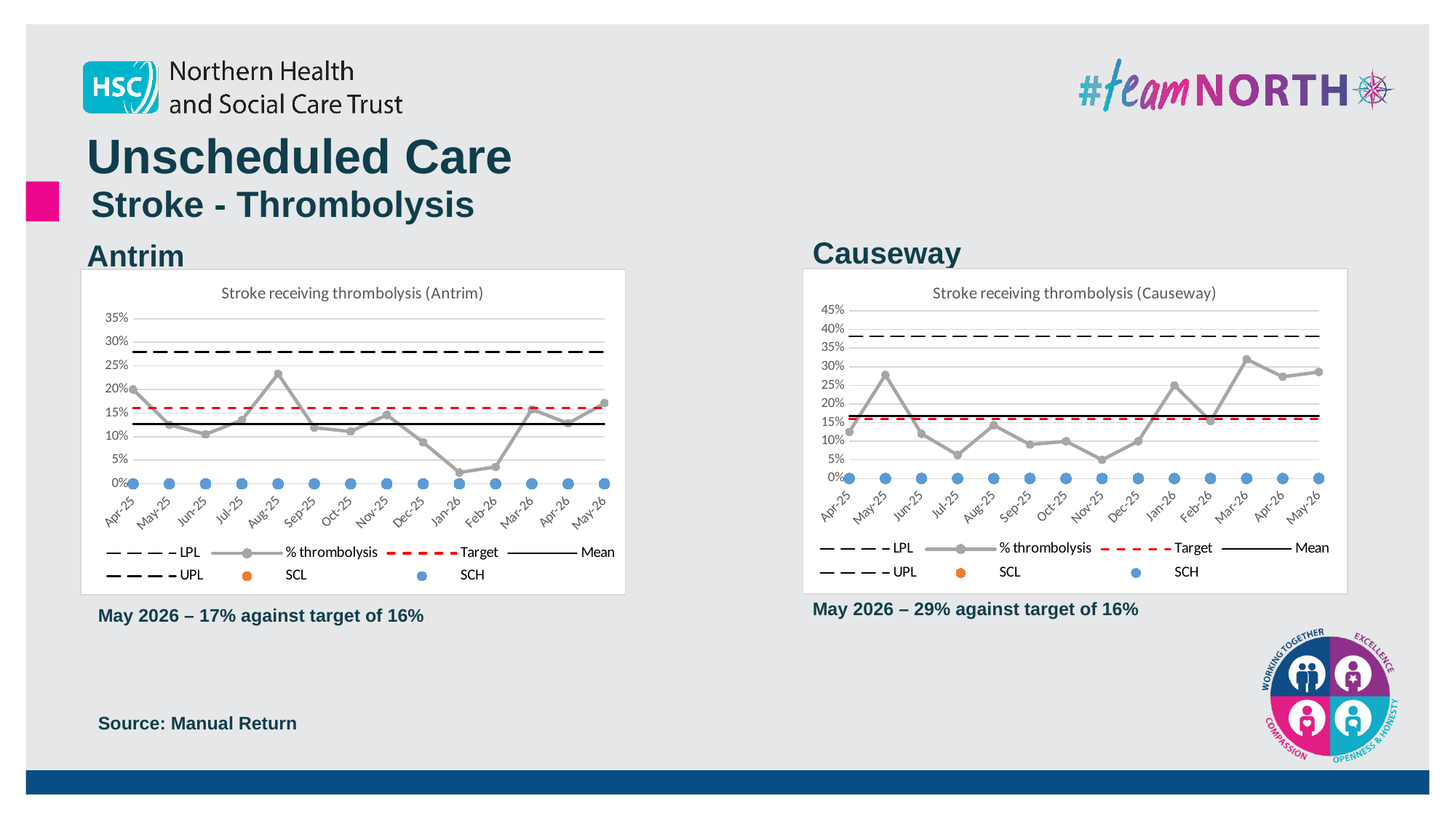
On the Antrim chart, what was the % thrombolysis value for May 2026? 17% On the Antrim chart, is the % thrombolysis value for Aug-25 greater or less than 20%? greater On the Antrim chart, which month has the lowest % thrombolysis value? Jan-26 On the Causeway chart, is the % thrombolysis value for Jul-25 greater or less than 10%? less On the Antrim chart, which month has the highest % thrombolysis value? Aug-25 On the Causeway chart, what was the % thrombolysis value for May 2026? 29% On the Causeway chart, which month has the highest % thrombolysis value? Mar-26 What kind of chart is the Causeway chart? Line chart On the Causeway chart, what is the target value for stroke receiving thrombolysis? 16% How many months are plotted on the x axis of the Antrim chart? 14 On the Causeway chart, by how many percentage points did the May 2026 value exceed the target of 16%? 13 percentage points Comparing the May 2026 values, which site had the higher % thrombolysis, Antrim or Causeway? Causeway